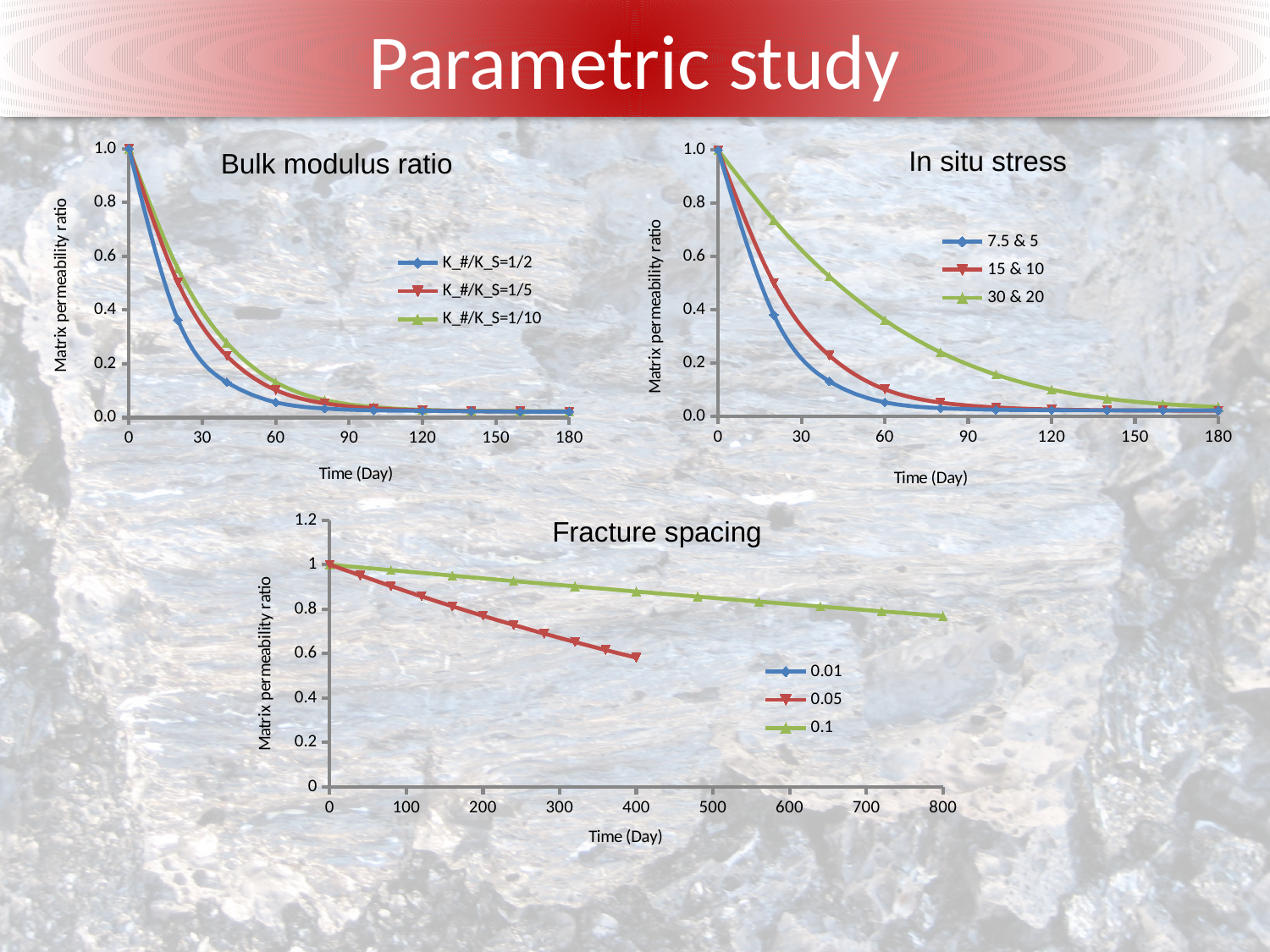
In the 'Bulk modulus ratio' chart, at 60 days, which series has the larger value: K_#/K_S=1/2 or K_#/K_S=1/10? K_#/K_S=1/10 What is the title of the chart at the bottom of the slide? Fracture spacing How many series does the legend of the 'In situ stress' chart list? 3 In the 'In situ stress' chart, is the value for the '30 & 20' series at 60 days greater or less than 0.2? greater In the 'In situ stress' chart, at 60 days, which series has the larger value: '7.5 & 5' or '30 & 20'? 30 & 20 In the 'Bulk modulus ratio' chart, do the values rise or fall as time increases? fall How many series does the legend of the 'Bulk modulus ratio' chart list? 3 What is the matrix permeability ratio at 0 days in the 'In situ stress' chart? 1.0 What kind of chart is the 'Bulk modulus ratio' chart? line chart In the 'Fracture spacing' chart, is the value for the 0.1 series at 800 days greater or less than 0.6? greater In the 'Bulk modulus ratio' chart, is the value for K_#/K_S=1/2 at 60 days greater or less than 0.2? less In the 'Fracture spacing' chart, at 400 days, which series has the larger value: 0.05 or 0.1? 0.1